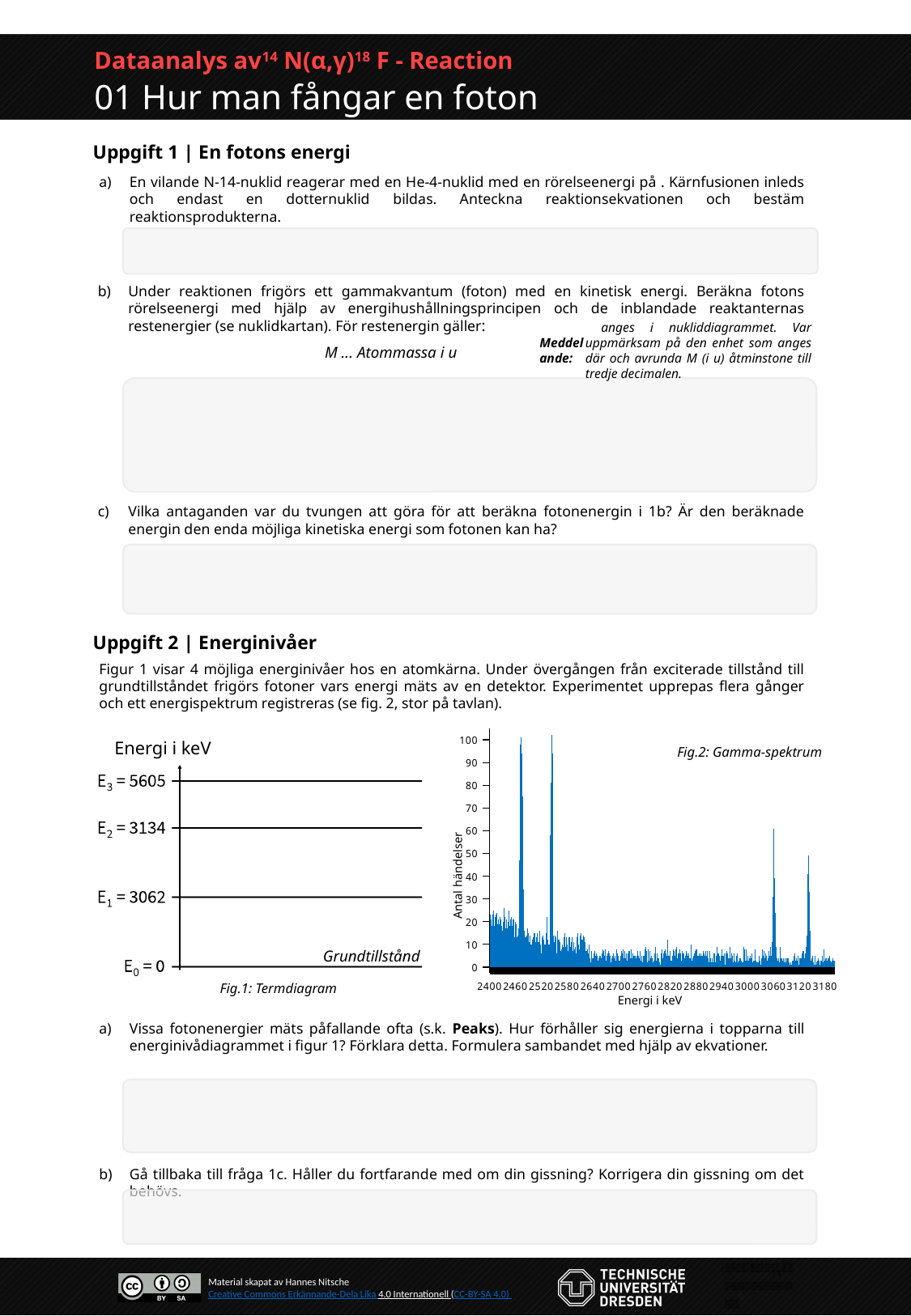
In Fig.1 (Termdiagram), what is the energy of level E2 in keV? 3134 In Fig.2 (Gamma-spektrum), is the peak near 3120 keV greater or less than 70 events? less In Fig.1 (Termdiagram), what is the difference in keV between E2 and E1? 72 In Fig.1 (Termdiagram), what label is given to the E0 = 0 level? Grundtillstånd In Fig.2 (Gamma-spektrum), is the peak near 3060 keV greater or less than 40 events? greater In Fig.2 (Gamma-spektrum), is the tallest peak near 2470 keV greater or less than 90 events? greater In Fig.1 (Termdiagram), which energy level is the highest? E3 = 5605 In Fig.1 (Termdiagram), how many energy levels are drawn? 4 In Fig.2 (Gamma-spektrum), what is the title of the vertical axis? Antal händelser In Fig.1 (Termdiagram), what is the difference in keV between E3 and E2? 2471 In Fig.1 (Termdiagram), what is the energy of level E3 in keV? 5605 In Fig.1 (Termdiagram), what is the energy of level E1 in keV? 3062